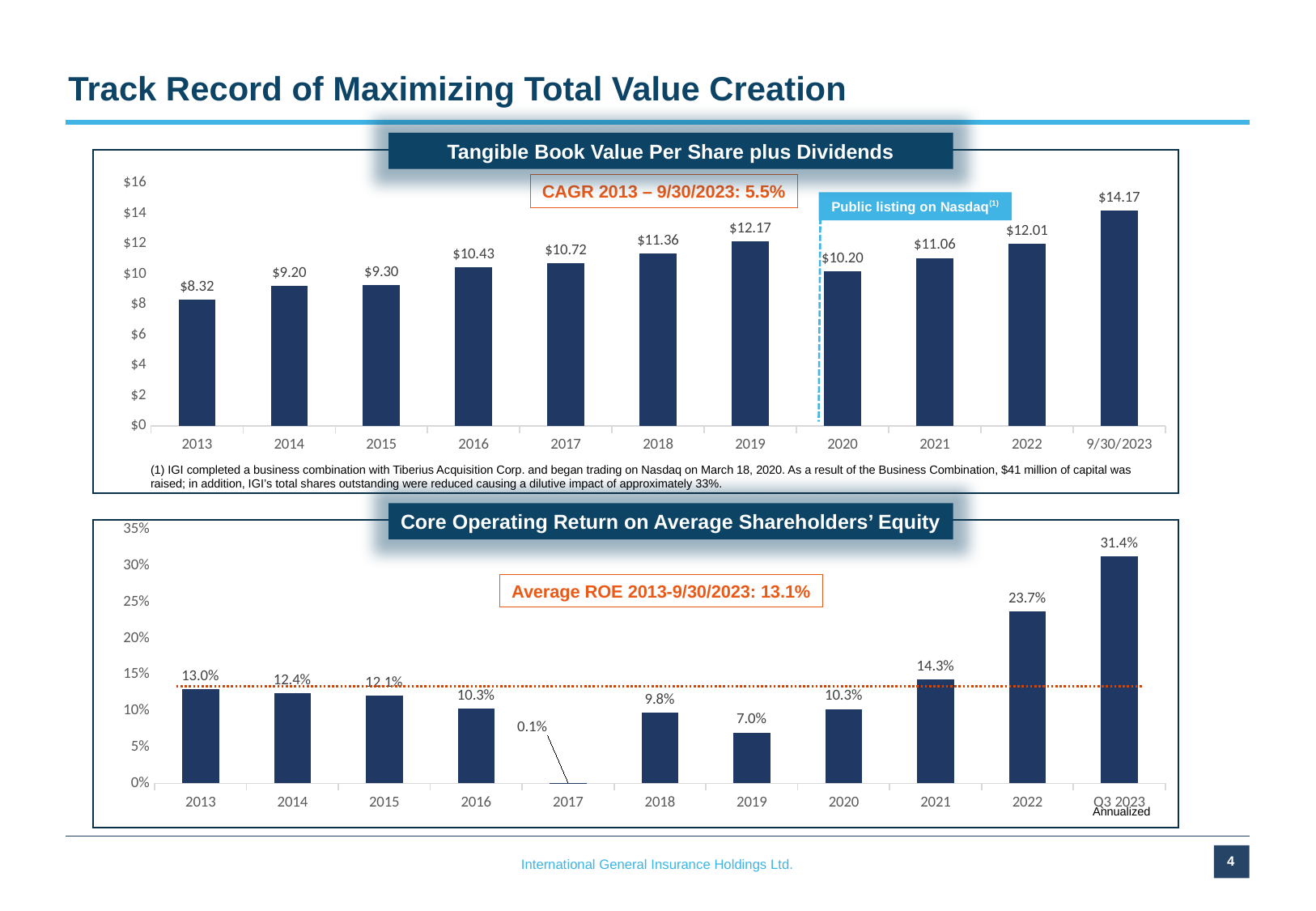
In the 'Tangible Book Value Per Share plus Dividends' chart, what is the difference between the 2019 value and the 2020 value? $1.97 In the 'Tangible Book Value Per Share plus Dividends' chart, how many bars are plotted? 11 In the 'Tangible Book Value Per Share plus Dividends' chart, what CAGR is stated for 2013 – 9/30/2023? 5.5% In the 'Tangible Book Value Per Share plus Dividends' chart, which category has the lowest value? 2013 In the 'Core Operating Return on Average Shareholders' Equity' chart, which category has the lowest value? 2017 In the 'Core Operating Return on Average Shareholders' Equity' chart, what is the difference between the 2022 value and the 2021 value? 9.4% In the 'Tangible Book Value Per Share plus Dividends' chart, what is the value for 2016? $10.43 In the 'Tangible Book Value Per Share plus Dividends' chart, which category has the highest value? 9/30/2023 In the 'Core Operating Return on Average Shareholders' Equity' chart, which category has the highest value? Q3 2023 Annualized In the 'Core Operating Return on Average Shareholders' Equity' chart, what is the value for 2019? 7.0% In the 'Core Operating Return on Average Shareholders' Equity' chart, which is larger, the value for 2013 or the value for 2021? 2021 What kind of chart is the 'Core Operating Return on Average Shareholders' Equity' chart? Bar chart